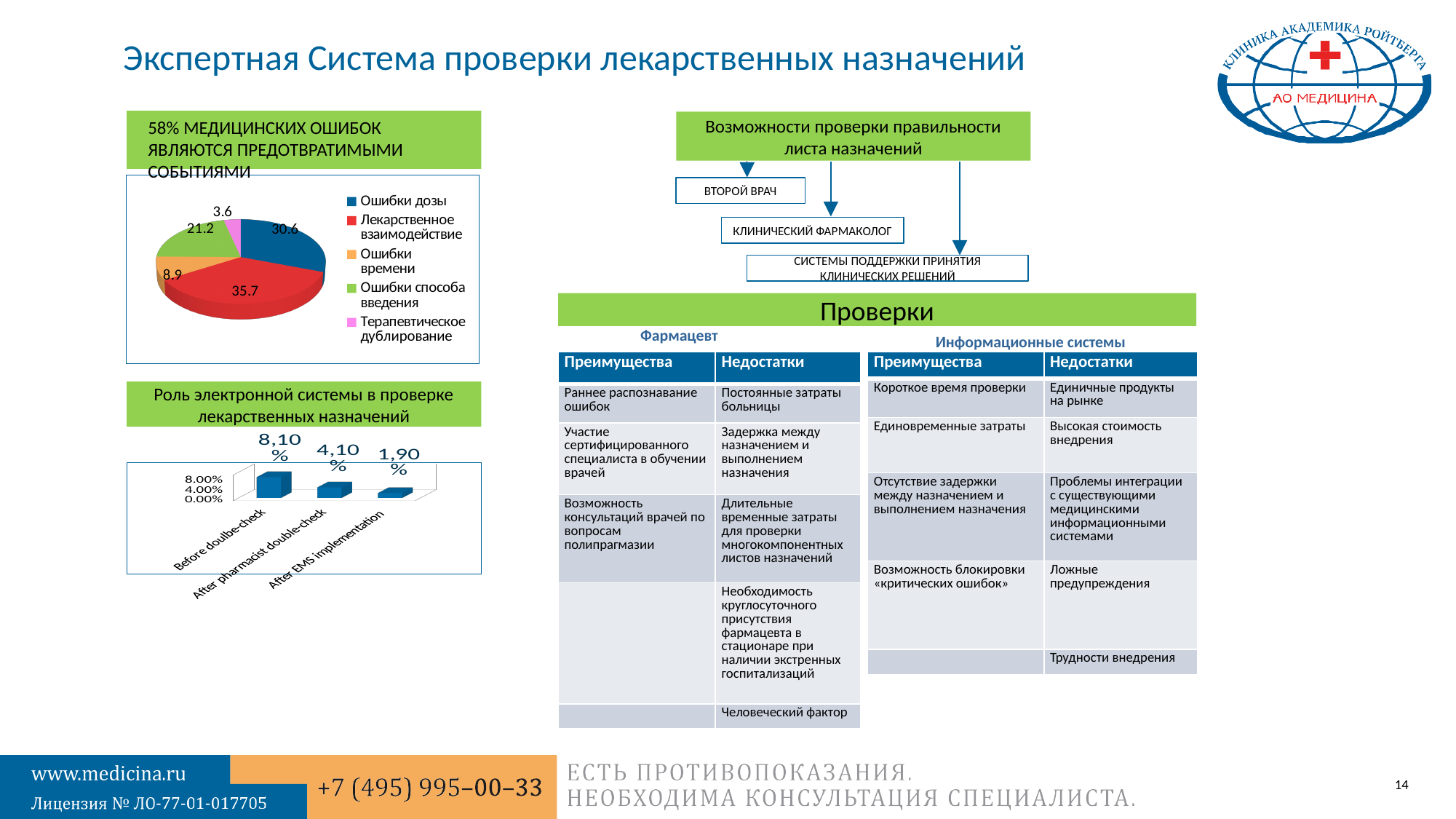
In the bar chart 'Роль электронной системы в проверке лекарственных назначений', what is the difference between the values for 'Before doulbe-check' and 'After EMS implementation'? 6,20% In the pie chart on the left of the slide, how many categories does the legend list? 5 In the pie chart on the left of the slide, which category has the smallest slice? Терапевтическое дублирование In the pie chart on the left of the slide, which category has the largest slice? Лекарственное взаимодействие What kind of chart is shown under the heading 'Роль электронной системы в проверке лекарственных назначений'? bar chart In the pie chart on the left of the slide, what is the difference between the values for Ошибки дозы and Ошибки способа введения? 9.4 In the bar chart 'Роль электронной системы в проверке лекарственных назначений', do the values rise or fall from left to right? fall In the pie chart on the left of the slide, which is larger: Ошибки дозы or Ошибки способа введения? Ошибки дозы In the pie chart on the left of the slide, what value is shown for Лекарственное взаимодействие? 35.7 In the pie chart on the left of the slide, what value is shown for Ошибки времени? 8.9 In the bar chart 'Роль электронной системы в проверке лекарственных назначений', what is the value for 'Before doulbe-check'? 8,10% In the bar chart 'Роль электронной системы в проверке лекарственных назначений', what is the value for 'After EMS implementation'? 1,90%